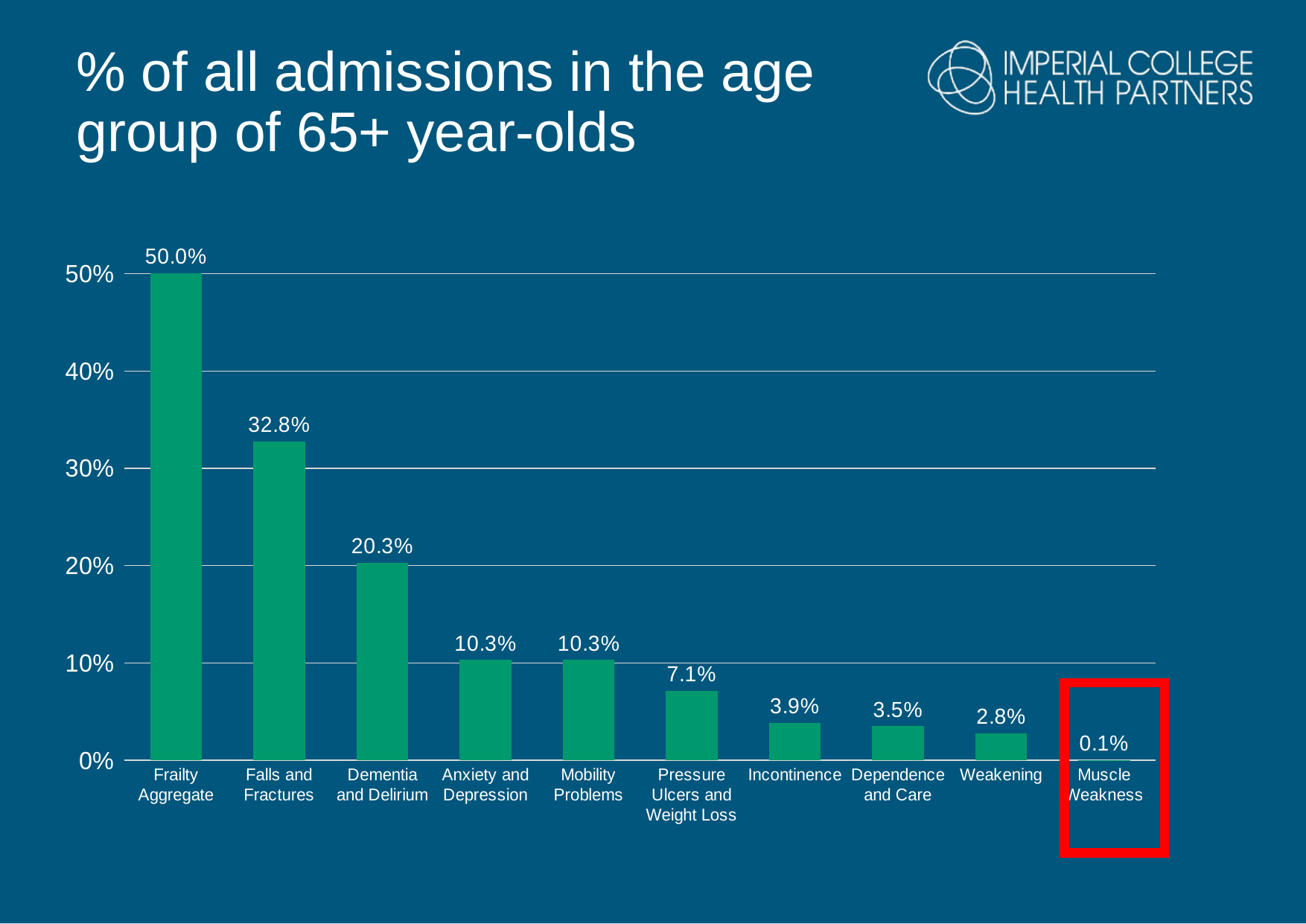
Which category has the lowest value? Muscle Weakness What is the value for Dementia and Delirium? 20.3% How many categories are shown on the x axis? 10 What is the value for Falls and Fractures? 32.8% What is the value for Pressure Ulcers and Weight Loss? 7.1% What is the difference between Incontinence and Dependence and Care? 0.4% Which category has the highest value? Frailty Aggregate What kind of chart is shown on the slide? Bar chart What is the value for Muscle Weakness? 0.1% What is the difference between Frailty Aggregate and Falls and Fractures? 17.2% Which is larger, Dementia and Delirium or Mobility Problems? Dementia and Delirium Do the values rise or fall from left to right along the x axis? Fall